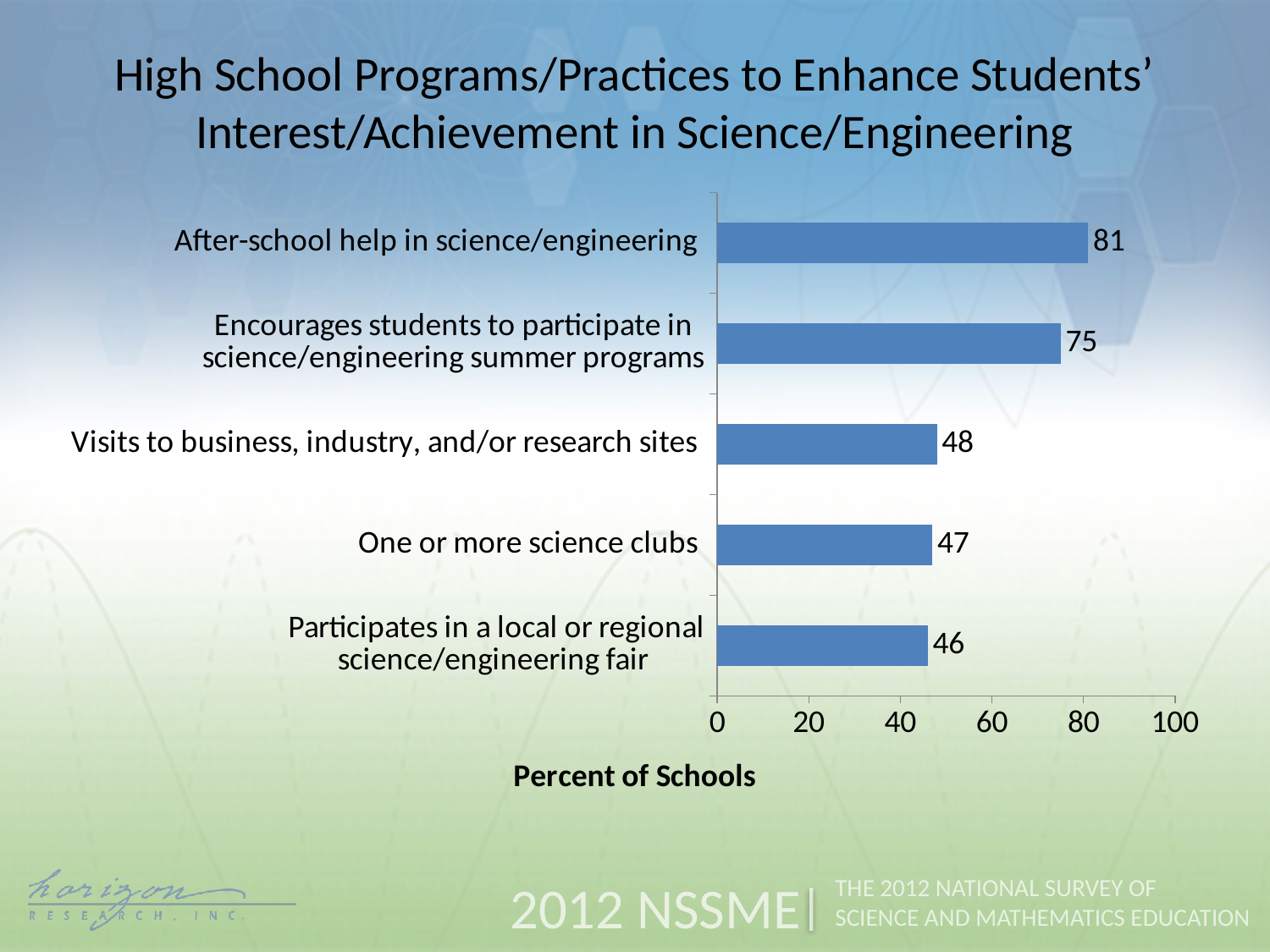
What is the maximum value shown on the horizontal axis? 100 What percent of schools offer after-school help in science/engineering? 81 What kind of chart is shown on the slide? Bar chart What is the value for 'Visits to business, industry, and/or research sites'? 48 Is the value for 'One or more science clubs' greater or less than 60? less Which is larger: the value for 'One or more science clubs' or the value for 'Encourages students to participate in science/engineering summer programs'? Encourages students to participate in science/engineering summer programs How many programs/practices are shown in the chart? 5 What is the difference between the values for after-school help in science/engineering and encouraging students to participate in science/engineering summer programs? 6 Which program/practice has the lowest percent of schools? Participates in a local or regional science/engineering fair Which program/practice has the highest percent of schools? After-school help in science/engineering What percent of schools participate in a local or regional science/engineering fair? 46 What is the label of the horizontal axis? Percent of Schools